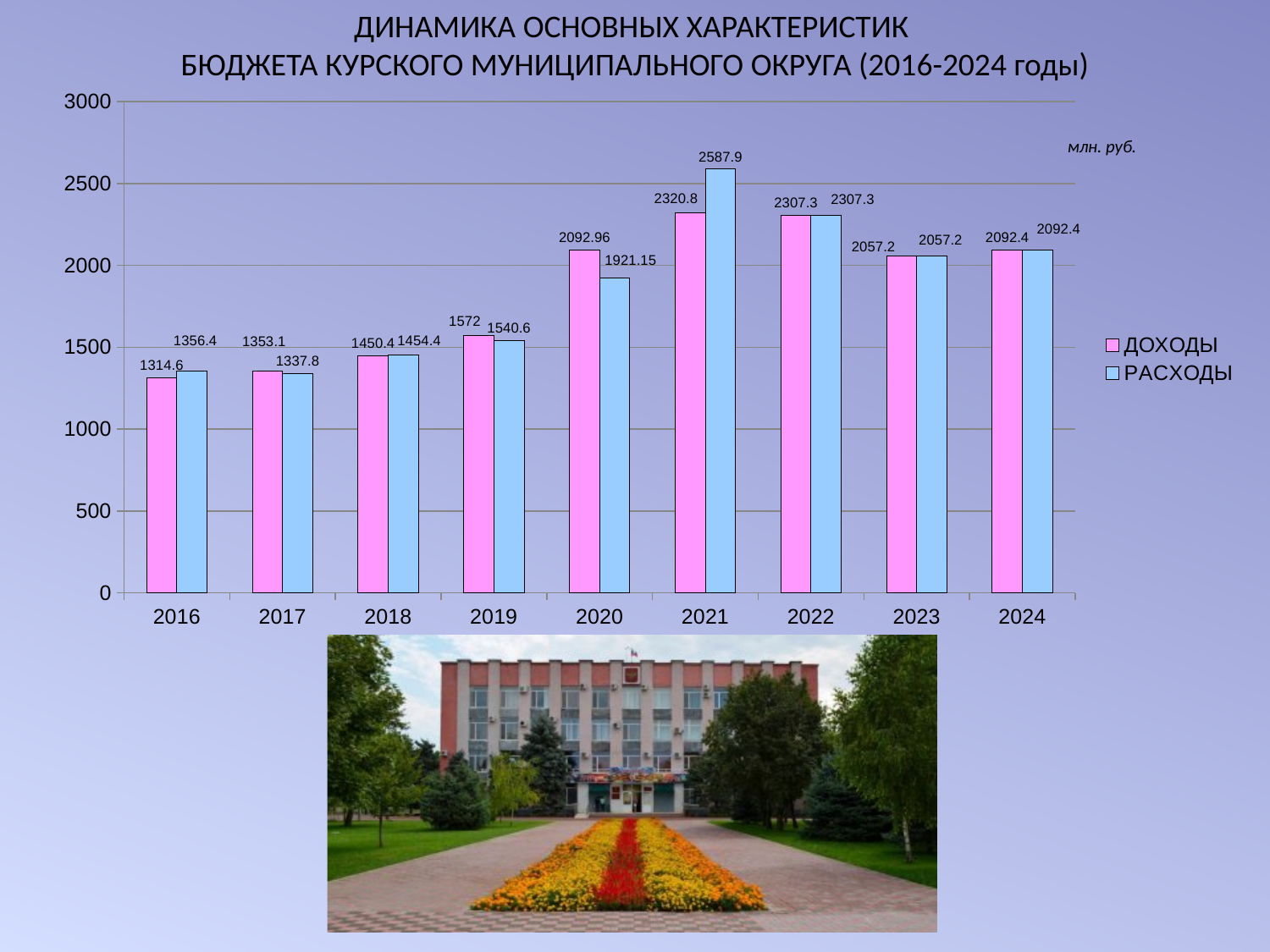
What is the value of РАСХОДЫ for 2016? 1356.4 What is the difference between РАСХОДЫ and ДОХОДЫ in 2021? 267.1 What kind of chart is shown on the slide? bar chart In which year is ДОХОДЫ the lowest? 2016 What is the value of РАСХОДЫ for 2021? 2587.9 Is the value of ДОХОДЫ for 2019 greater or less than 1500? greater How many years are shown on the x axis? 9 What unit is indicated for the values on the chart? млн. руб. In which year is РАСХОДЫ the highest? 2021 What is the value of ДОХОДЫ for 2020? 2092.96 In 2020, which is larger, ДОХОДЫ or РАСХОДЫ? ДОХОДЫ How many series does the legend list? 2